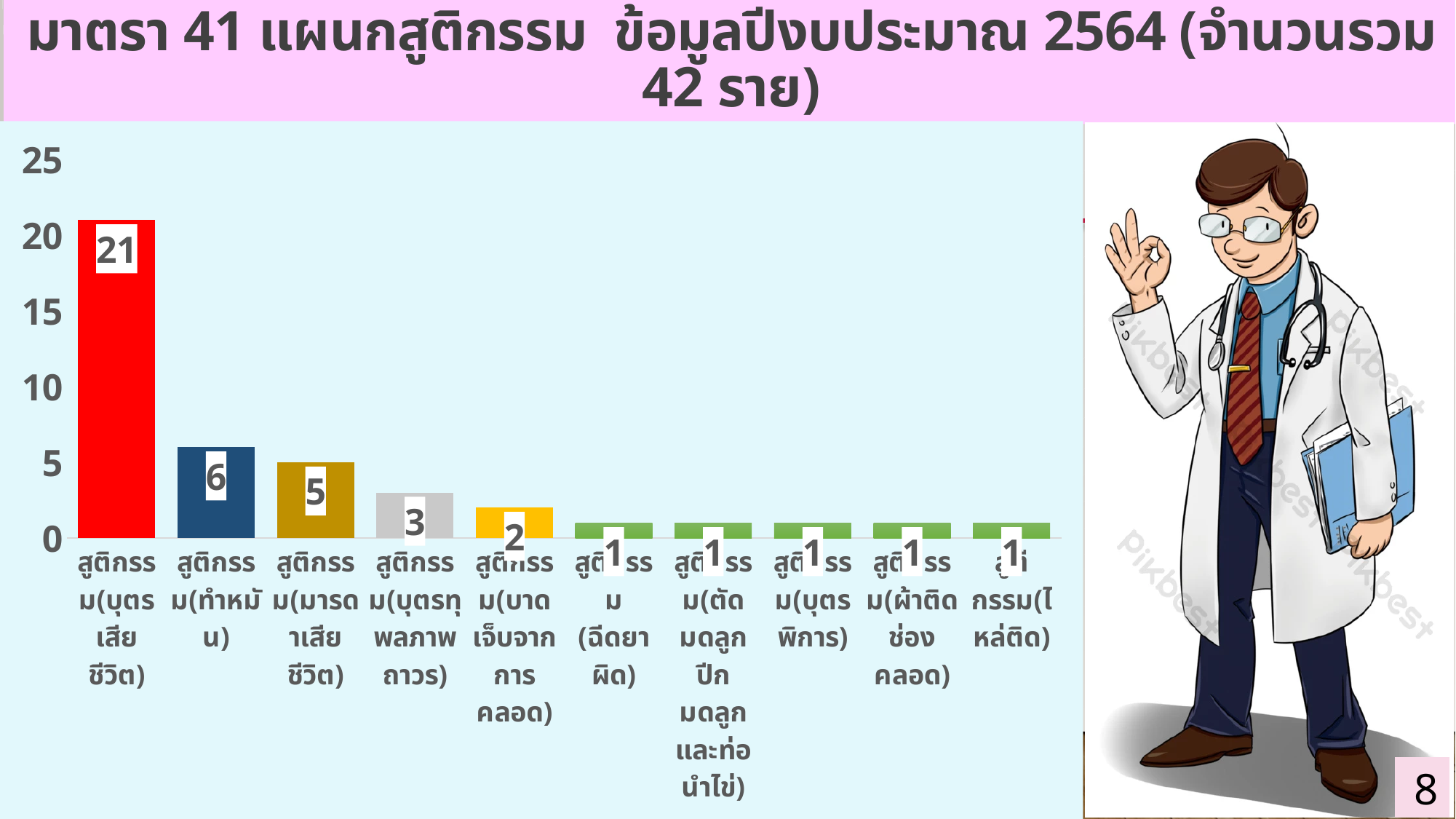
What is the value for สูติกรรม(บุตรพิการ)? 1 What is the value for สูติกรรม(บุตรเสียชีวิต)? 21 What is the difference between the values for สูติกรรม(บุตรเสียชีวิต) and สูติกรรม(ทำหมัน)? 15 Is the value for สูติกรรม(บุตรเสียชีวิต) greater or less than 20? greater How many categories are shown on the x axis of the chart? 10 What is the value for สูติกรรม(ทำหมัน)? 6 What is the value for สูติกรรม(บุตรทุพลภาพถาวร)? 3 What is the value for สูติกรรม(มารดาเสียชีวิต)? 5 What is the value for สูติกรรม(บาดเจ็บจากการคลอด)? 2 What type of chart is shown on the slide? bar chart Which category has the highest value? สูติกรรม(บุตรเสียชีวิต) Which is larger, the value for สูติกรรม(มารดาเสียชีวิต) or สูติกรรม(บุตรทุพลภาพถาวร)? สูติกรรม(มารดาเสียชีวิต)